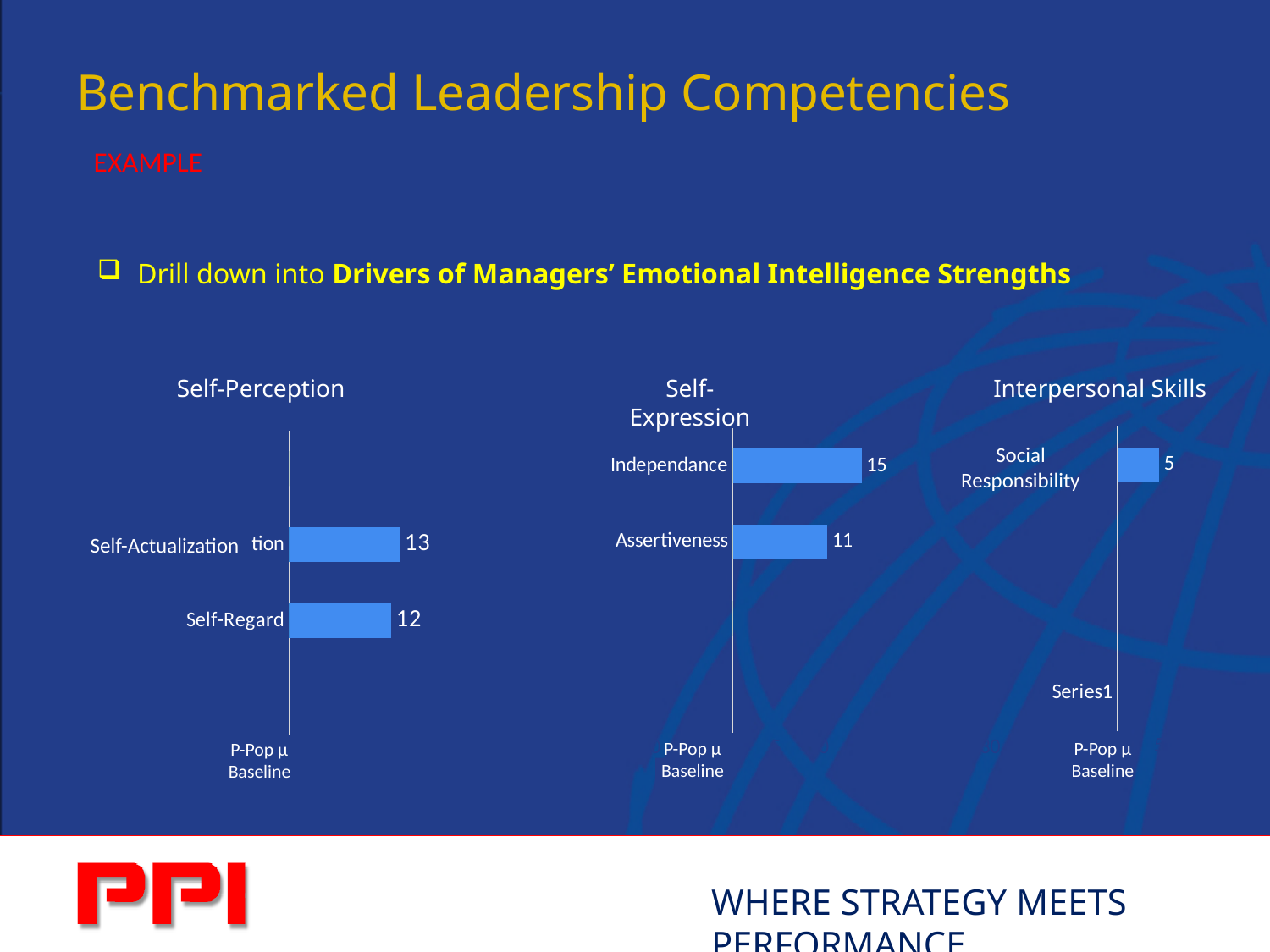
In the Interpersonal Skills chart, what is the value for Social Responsibility? 5 What kind of chart is the Self-Expression chart? Bar chart In the Self-Expression chart, which category has the highest value? Independance What is the title of the chart on the right of the slide? Interpersonal Skills In the Self-Perception chart, what is the value for Self-Actualization? 13 How many bars are plotted in the Self-Expression chart? 2 In the Self-Perception chart, what is the difference between Self-Actualization and Self-Regard? 1 In the Self-Perception chart, what is the value for Self-Regard? 12 In the Self-Perception chart, which is larger, Self-Actualization or Self-Regard? Self-Actualization In the Self-Expression chart, what is the value for Independance? 15 In the Self-Expression chart, what is the difference between Independance and Assertiveness? 4 In the Self-Expression chart, what is the value for Assertiveness? 11